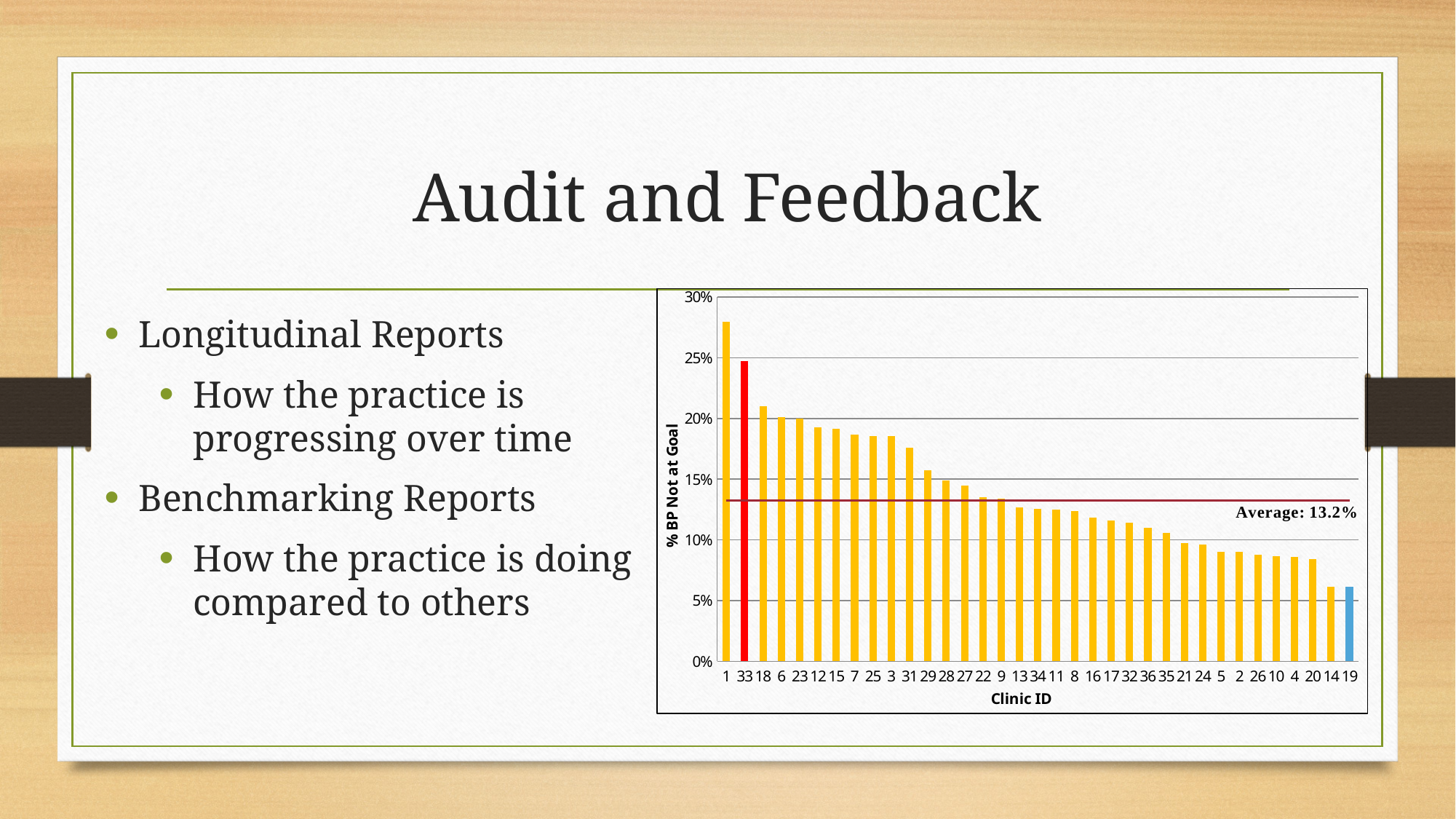
What kind of chart is shown on the slide? bar chart Is the value for clinic 22 greater or less than 15%? less Is the value for clinic 1 greater or less than 25%? greater Which clinic ID has the highest % BP Not at Goal? 1 Is the value for clinic 18 greater or less than 20%? greater What is the average value shown by the horizontal line on the chart? 13.2% Which has a higher % BP Not at Goal, clinic 1 or clinic 33? clinic 1 How many clinics are plotted on the x axis of the chart? 35 Do the bar values rise or fall moving from left to right along the x axis? fall Which clinic ID is shown with a red bar? 33